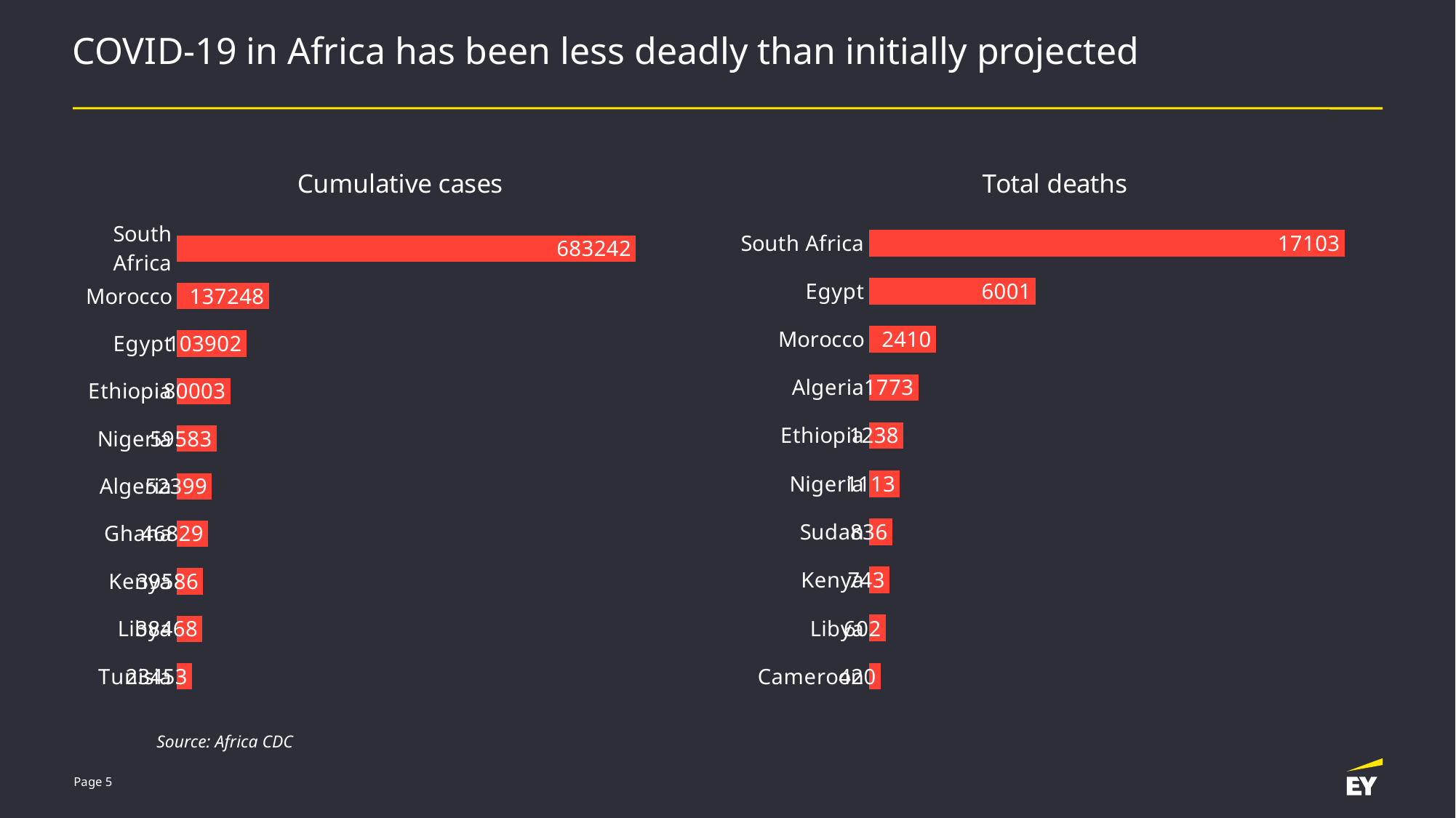
In the Cumulative cases chart, what is the difference between South Africa and Morocco? 545994 In the Total deaths chart, what is the value for South Africa? 17103 In the Cumulative cases chart, which country has the highest value? South Africa In the Total deaths chart, what is the value for Morocco? 2410 How many countries are shown in the Total deaths chart? 10 In the Cumulative cases chart, what is the value for South Africa? 683242 In the Total deaths chart, what is the difference between South Africa and Egypt? 11102 What type of chart is the Cumulative cases chart? Bar chart In the Total deaths chart, what is the value for Egypt? 6001 In the Total deaths chart, which country has the highest value? South Africa In the Total deaths chart, which is larger, Egypt or Morocco? Egypt In the Cumulative cases chart, what is the value for Morocco? 137248